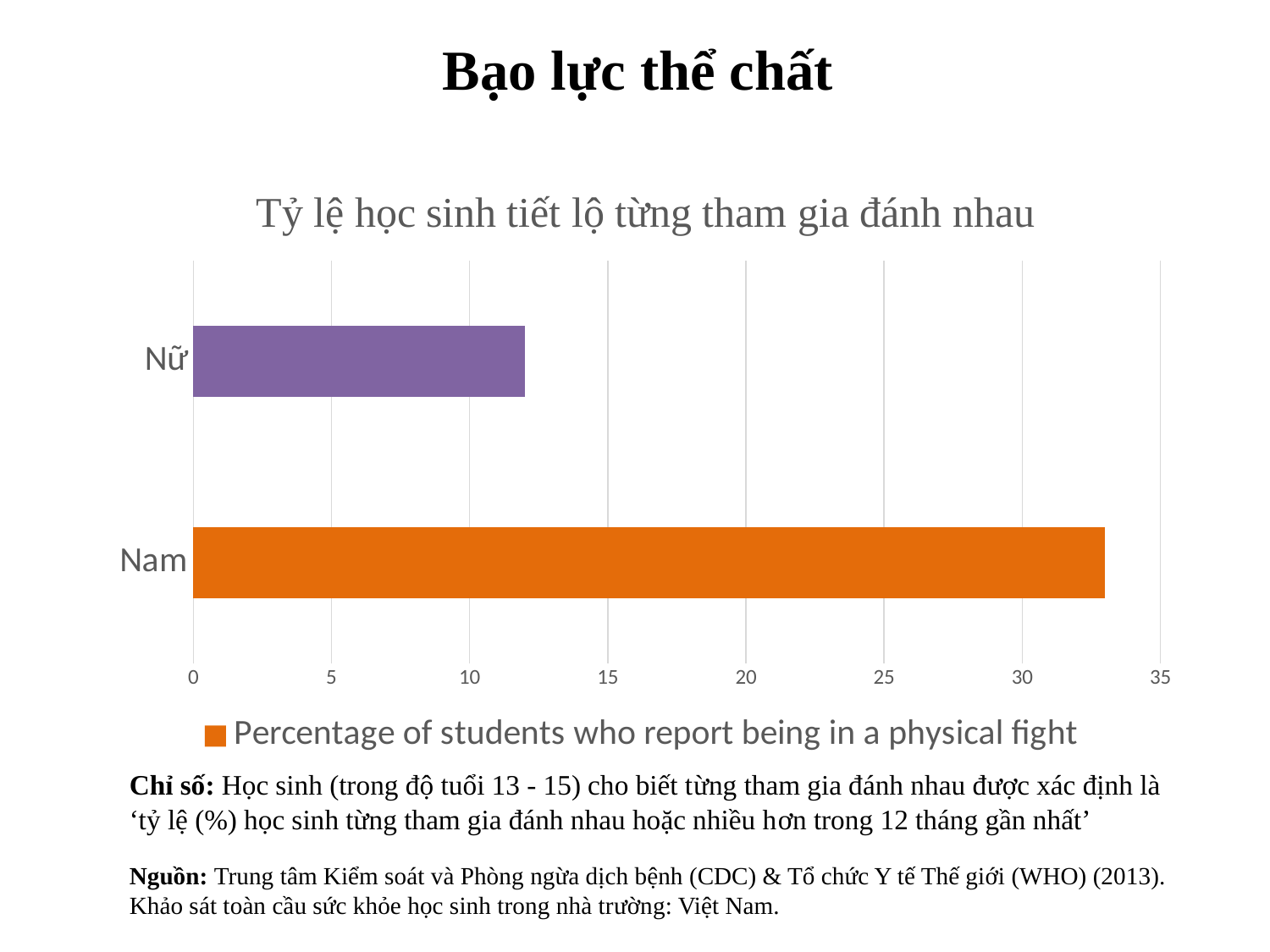
What is the legend entry shown below the chart? Percentage of students who report being in a physical fight Is the value for Nam greater or less than 35? less Is the value for Nữ greater or less than 10? greater Which category has the lowest value? Nữ Which is larger, the value for Nam or the value for Nữ? Nam Which category has the highest value? Nam Is the value for Nữ greater or less than 15? less How many series does the legend list? 1 What kind of chart is shown on the slide? bar chart How many categories are plotted in the chart? 2 What is the title of the chart? Tỷ lệ học sinh tiết lộ từng tham gia đánh nhau